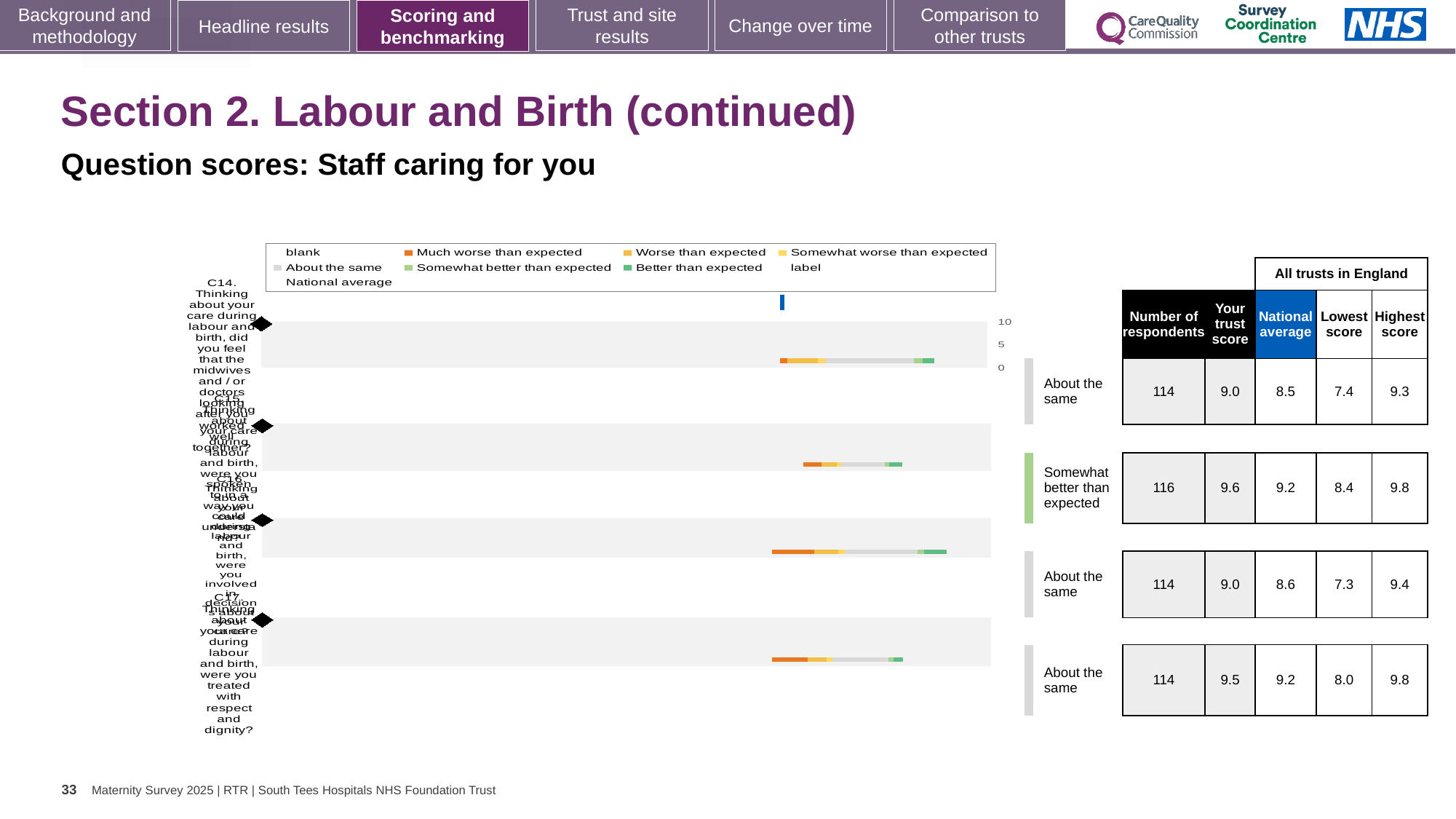
In the table next to the chart, what is the difference between the trust score (9.0) and the national average (8.5) for the first row? 0.5 In the table next to the chart, what is the highest score for the third row? 9.4 What kind of chart is shown on the slide? bar chart In the table next to the chart, what is the 'Your trust score' value for the second row (Somewhat better than expected)? 9.6 In the table next to the chart, which row has the highest 'Your trust score'? the second row (9.6) How many question rows (bars) does the chart show? 4 How many of the four rows are benchmarked as 'About the same'? 3 In the table next to the chart, is the trust score for the first row larger or smaller than its national average? larger In the table next to the chart, what is the number of respondents for the first row? 114 In the table next to the chart, what is the national average for the fourth row? 9.2 What is the title of the chart section shown on the slide? Question scores: Staff caring for you In the table next to the chart, which row has the lowest 'Lowest score' value? the third row (7.3)